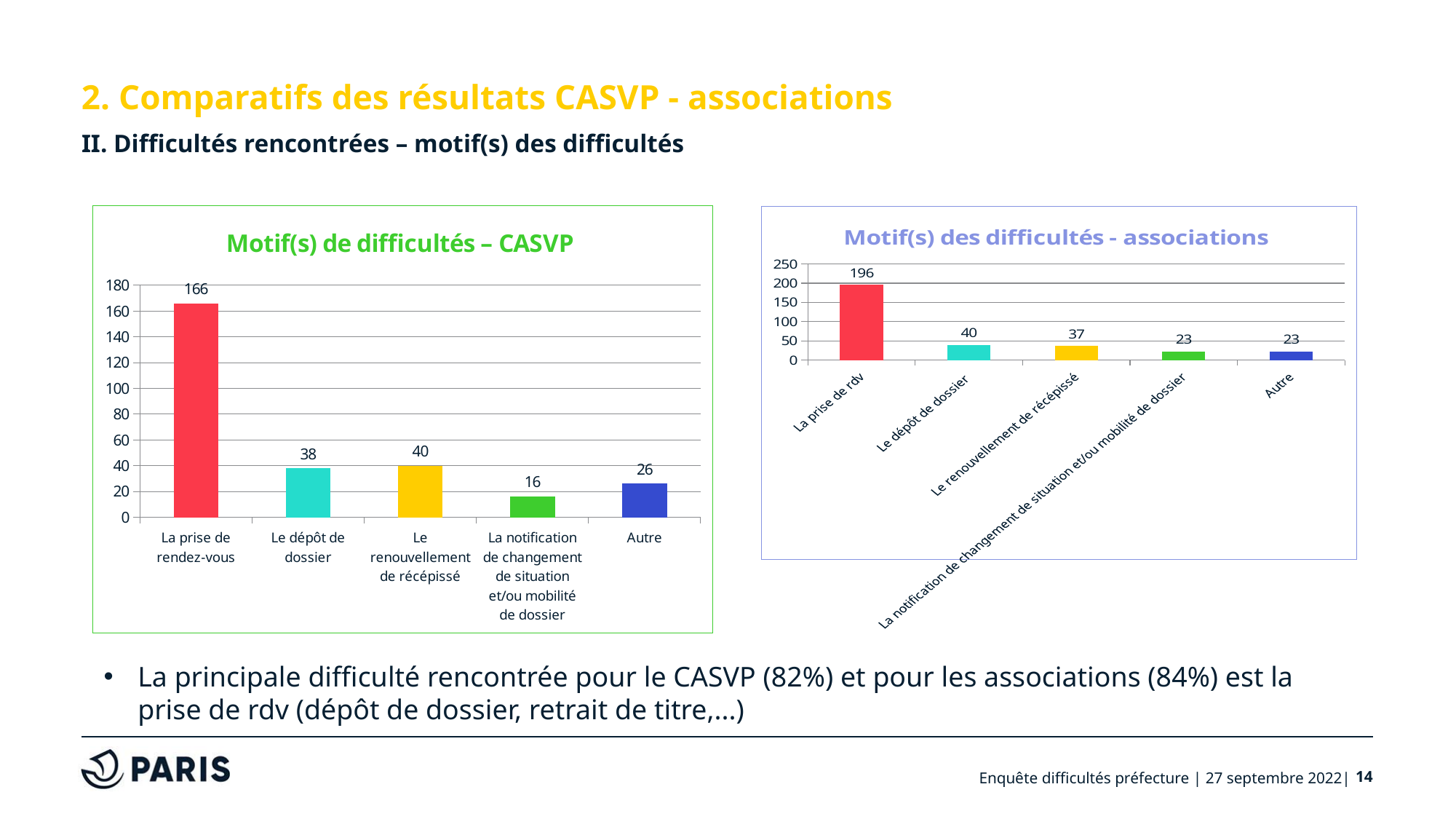
In the 'Motif(s) de difficultés – CASVP' chart, which is larger: 'Le dépôt de dossier' or 'Le renouvellement de récépissé'? Le renouvellement de récépissé In the 'Motif(s) de difficultés – CASVP' chart, what is the difference between 'La prise de rendez-vous' and 'Le renouvellement de récépissé'? 126 In the 'Motif(s) de difficultés – CASVP' chart, what is the value for 'La prise de rendez-vous'? 166 How many categories are shown in the 'Motif(s) de difficultés – CASVP' chart? 5 In the 'Motif(s) de difficultés – CASVP' chart, what is the value for 'Autre'? 26 In the 'Motif(s) de difficultés – CASVP' chart, which category has the lowest value? La notification de changement de situation et/ou mobilité de dossier What is the title of the chart on the right side of the slide? Motif(s) des difficultés - associations In the 'Motif(s) des difficultés - associations' chart, what is the value for 'Le renouvellement de récépissé'? 37 In the 'Motif(s) des difficultés - associations' chart, which category has the highest value? La prise de rdv In the 'Motif(s) des difficultés - associations' chart, what is the difference between 'Le dépôt de dossier' and 'Autre'? 17 What kind of chart is the 'Motif(s) des difficultés - associations' chart? Bar chart In the 'Motif(s) des difficultés - associations' chart, is the value for 'La prise de rdv' greater or less than 150? greater